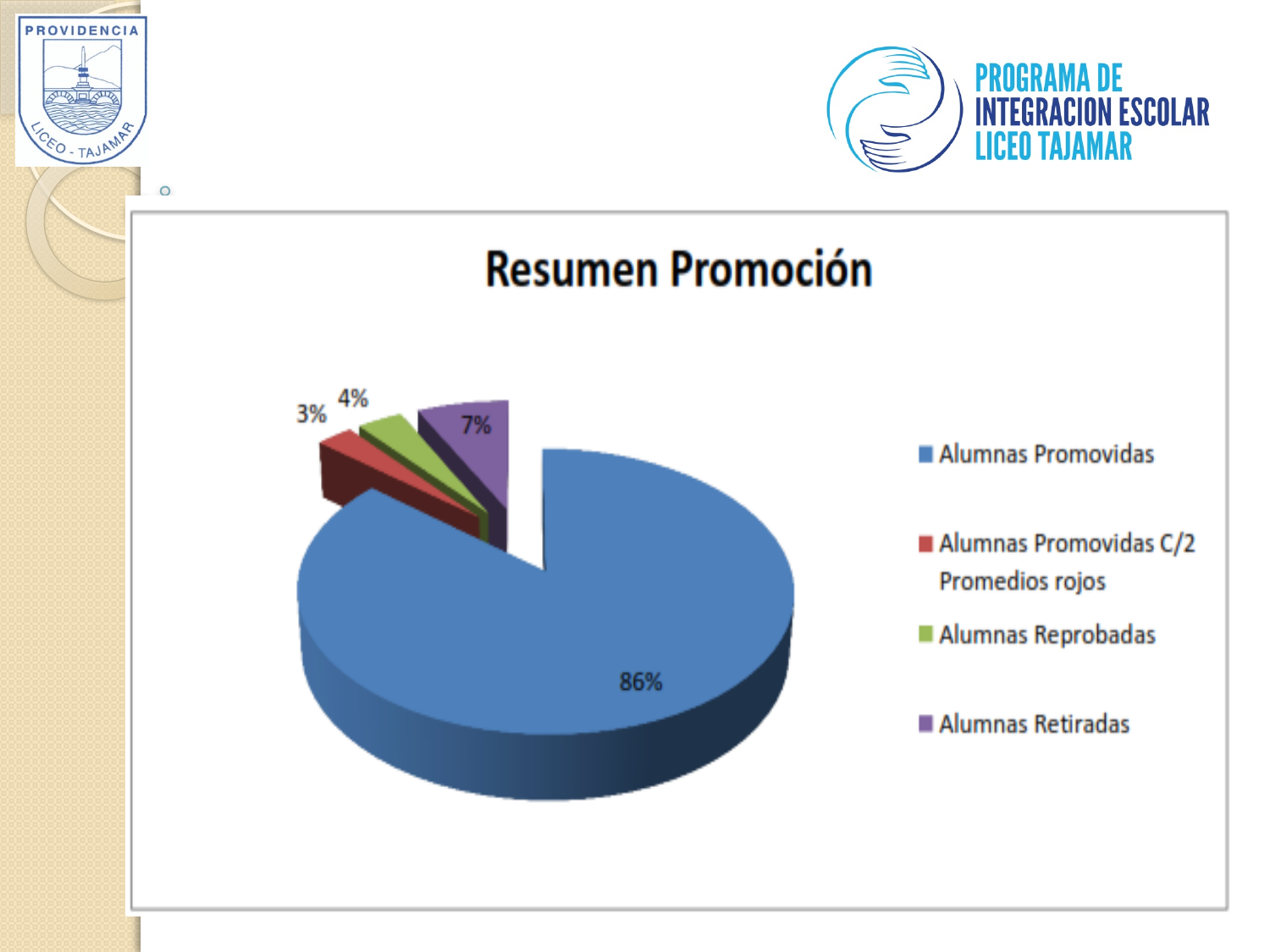
What percentage of the pie is Alumnas Reprobadas? 4% What kind of chart is shown on the slide? Pie chart Which category has the largest share of the pie? Alumnas Promovidas Which is larger, the share for Alumnas Retiradas or the share for Alumnas Reprobadas? Alumnas Retiradas What is the difference in percentage points between Alumnas Promovidas and Alumnas Retiradas? 79 What percentage of the pie is Alumnas Promovidas? 86% What is the title of the chart? Resumen Promoción How many categories does the legend list? 4 What colour is the slice for Alumnas Reprobadas? Green Which category has the smallest share of the pie? Alumnas Promovidas C/2 Promedios rojos What percentage of the pie is Alumnas Promovidas C/2 Promedios rojos? 3% What percentage of the pie is Alumnas Retiradas? 7%